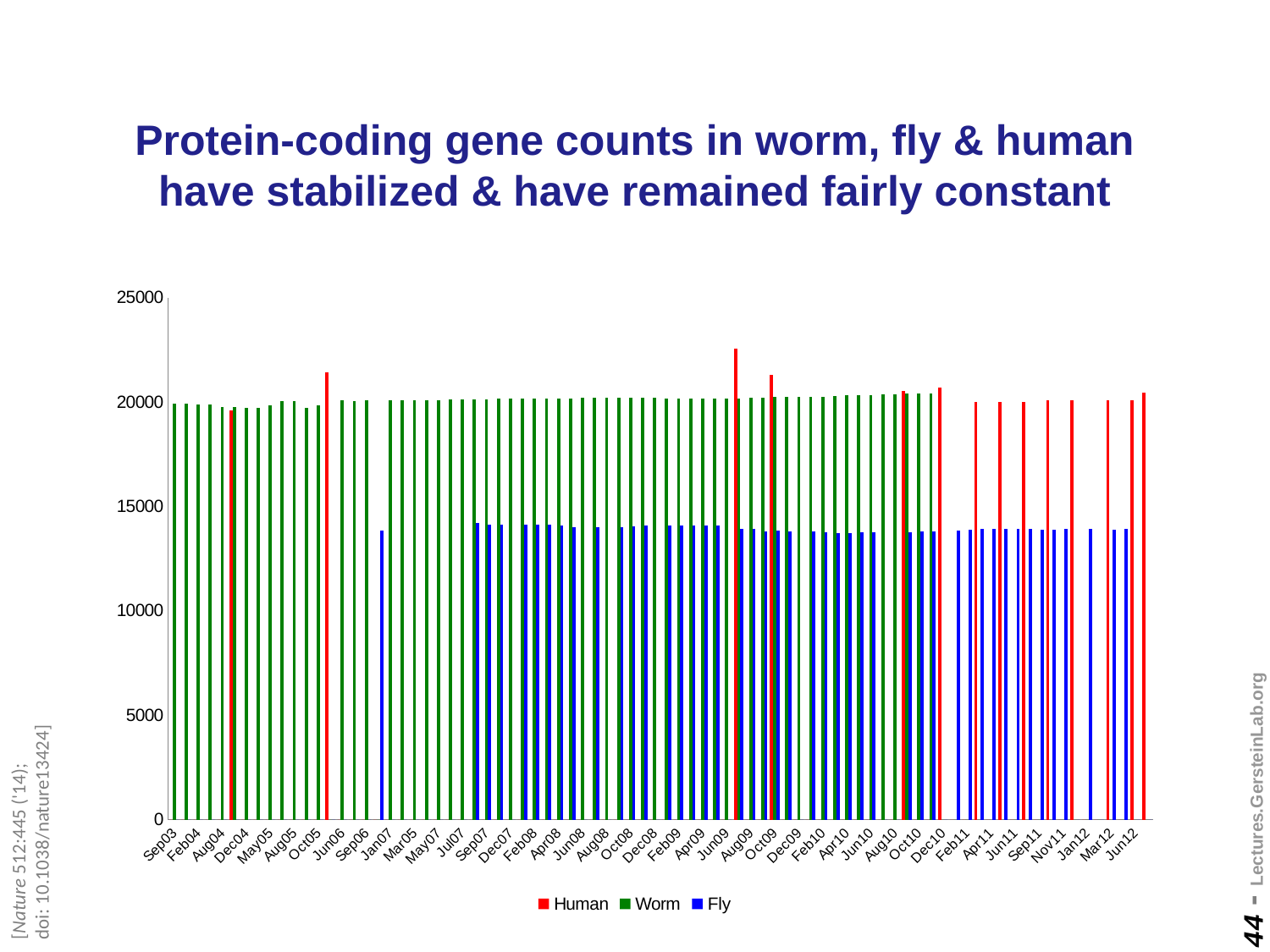
Which series has the lowest values throughout the chart? Fly What kind of chart is shown on the slide? bar chart How many series does the legend list? 3 Do the Fly values rise sharply, fall sharply, or stay roughly flat across the x axis? roughly flat What is the title of the slide's chart? Protein-coding gene counts in worm, fly & human have stabilized & have remained fairly constant Which series is shown in blue in the legend? Fly Is the Worm value for Sep03 greater or less than 15000? greater At Jan07, which is larger, the Worm value or the Fly value? Worm